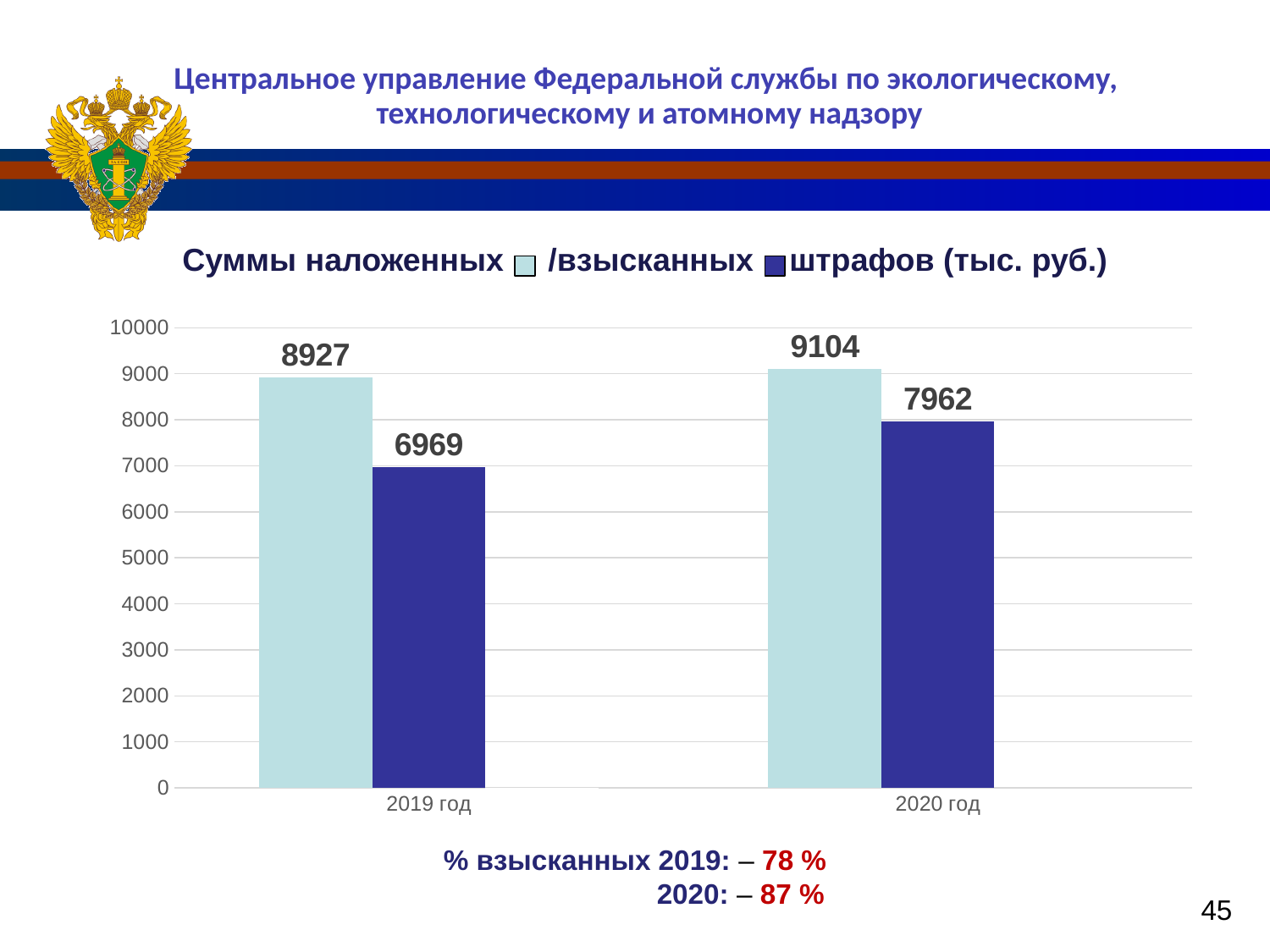
What is the value of the collected fines (взысканных) bar for 2019 год? 6969 What is the value of the imposed fines (наложенных) bar for 2019 год? 8927 Which bar on the chart has the highest value? Imposed fines (наложенных) for 2020 год, 9104 How many year categories are shown on the x axis? 2 What type of chart is shown on the slide? Bar chart What is the difference between imposed fines in 2020 год and 2019 год? 177 How many series does the chart legend list? 2 Is the value of collected fines for 2019 год greater or less than 7000? less What is the value of the collected fines (взысканных) bar for 2020 год? 7962 What is the difference between imposed and collected fines in 2019 год? 1958 Which is larger: collected fines in 2019 год or collected fines in 2020 год? 2020 год Which bar on the chart has the lowest value? Collected fines (взысканных) for 2019 год, 6969